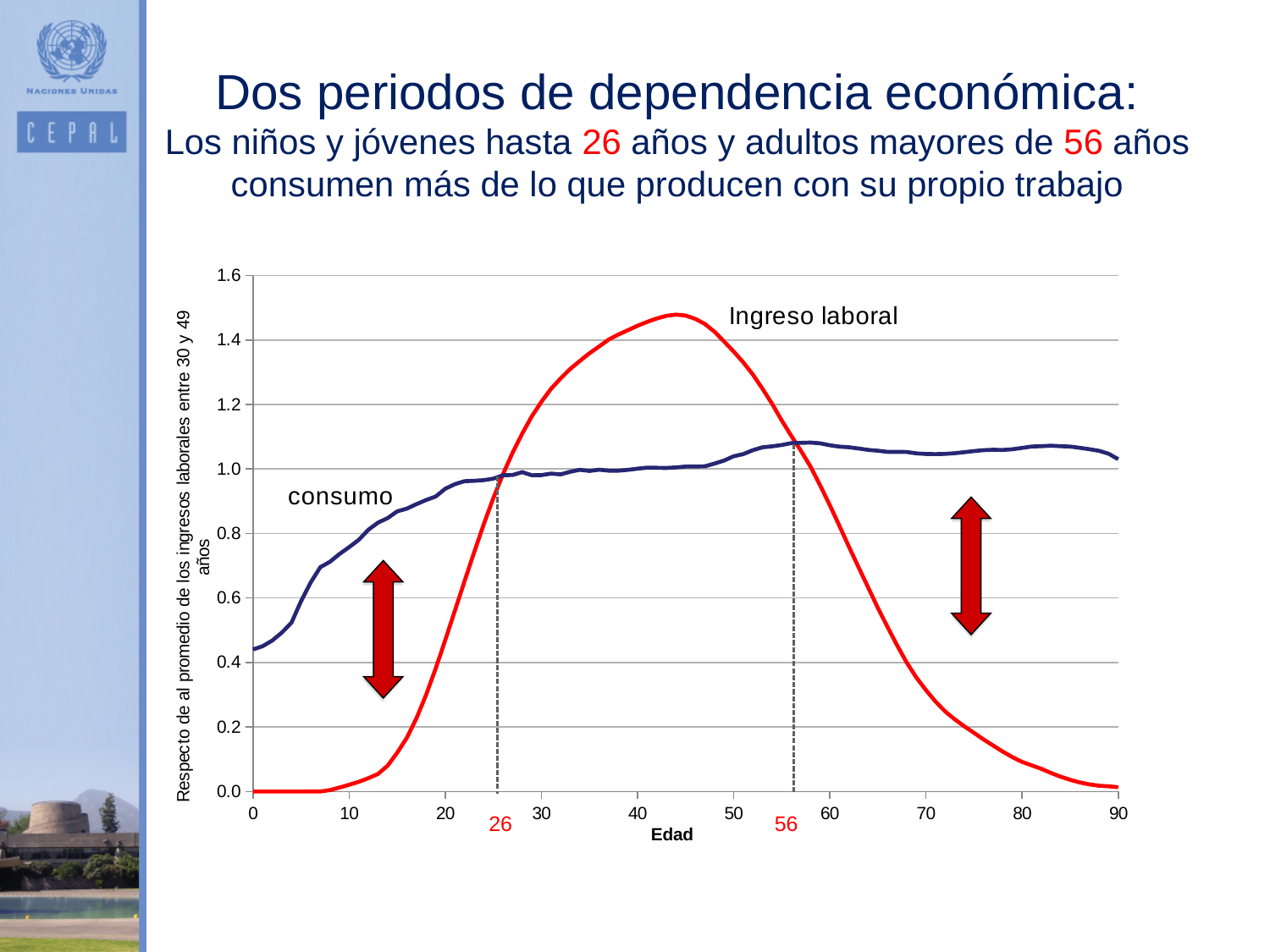
Does the Ingreso laboral series rise or fall between age 50 and age 90? fall Does the consumo series rise or fall between age 0 and age 30? rise How many series (lines) are plotted on the chart? 2 At age 10, which series is higher, consumo or Ingreso laboral? consumo Is the value of Ingreso laboral at age 80 greater or less than 0.2? less At age 40, which series is higher, consumo or Ingreso laboral? Ingreso laboral What is the title of the x axis of the chart? Edad Which two ages are marked in red below the x axis where the two curves cross? 26 and 56 At age 70, which series is higher, consumo or Ingreso laboral? consumo Is the value of Ingreso laboral at age 40 greater or less than 1.2? greater Is the value of consumo at age 0 greater or less than 0.6? less What kind of chart is shown on the slide? line chart